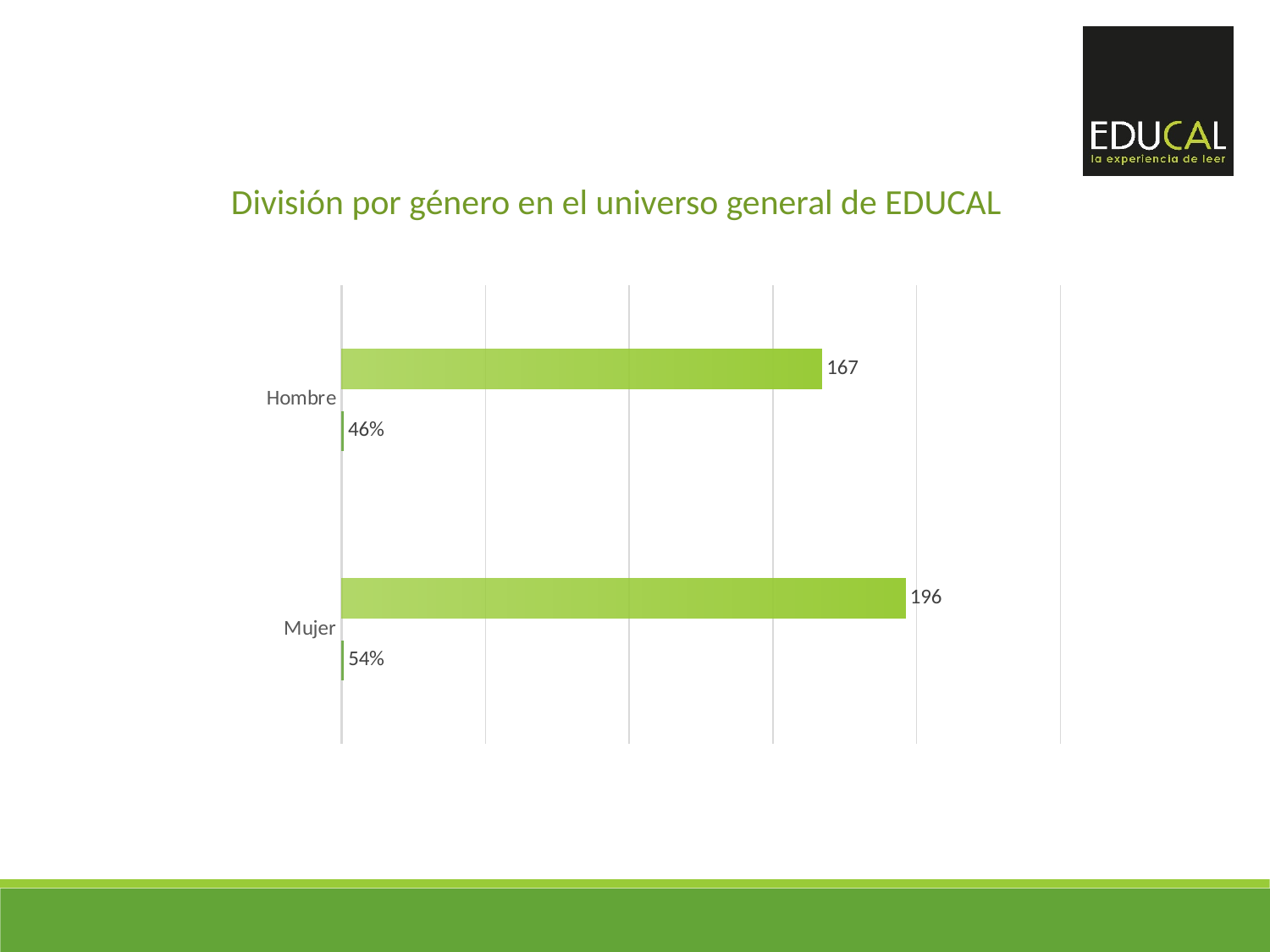
Which category has the lower percentage? Hombre What is the count value shown for Hombre? 167 How many categories are shown on the chart? 2 Is the count for Hombre larger or smaller than the count for Mujer? smaller What is the count value shown for Mujer? 196 What is the difference between the percentages for Mujer and Hombre? 8% What percentage is shown for Mujer? 54% What is the title of the chart? División por género en el universo general de EDUCAL What percentage is shown for Hombre? 46% Which category has the higher count value? Mujer What kind of chart is shown on the slide? bar chart What is the difference between the count values for Mujer and Hombre? 29